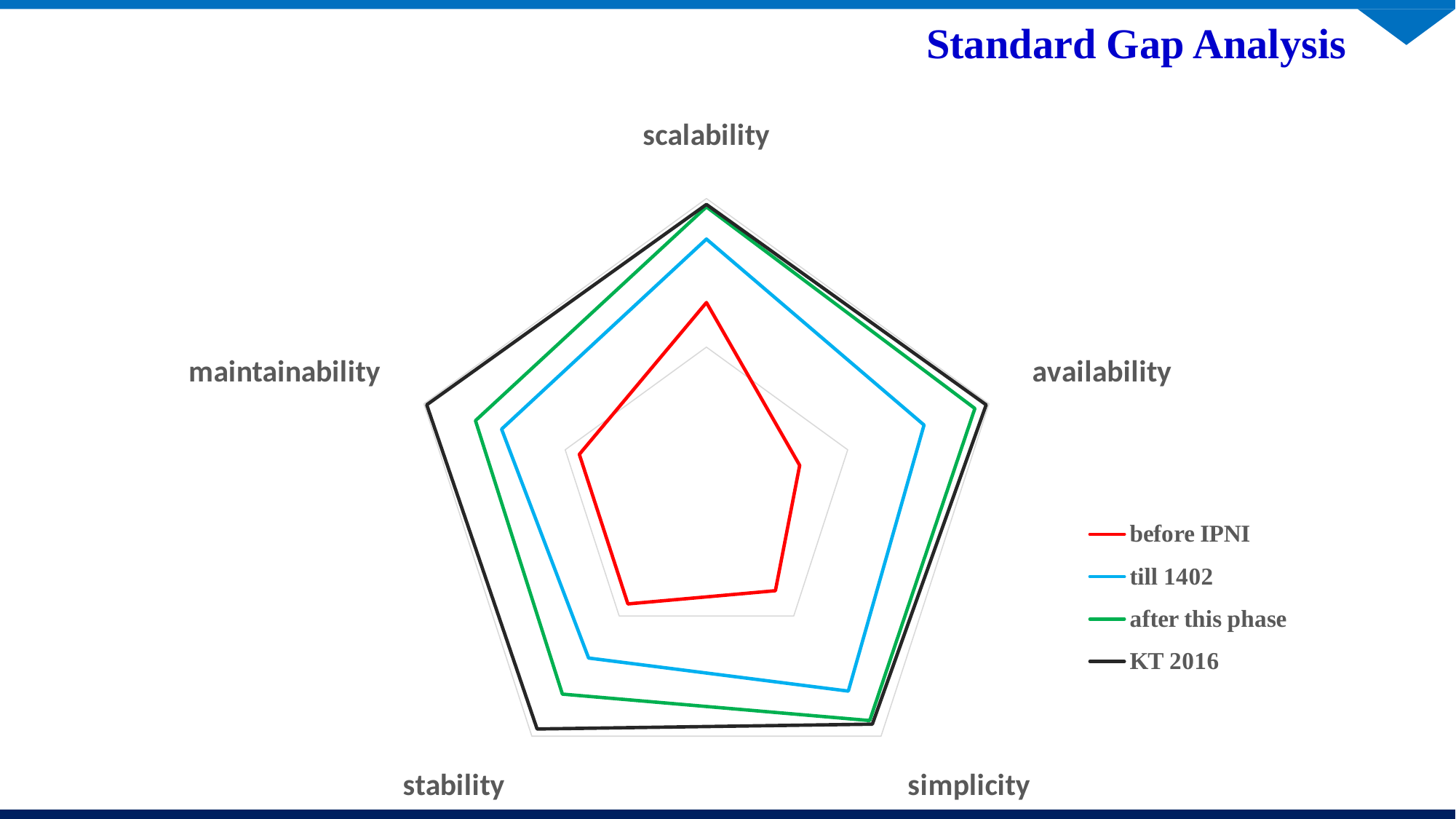
What kind of chart is shown on the slide? Radar chart For the 'before IPNI' series, which category has the highest value? scalability For scalability, which series has a larger value: 'KT 2016' or 'before IPNI'? KT 2016 For maintainability, which series has a larger value: 'KT 2016' or 'after this phase'? KT 2016 How many series does the legend list? 4 Which series has the largest values across all categories? KT 2016 What is the title of the slide containing the chart? Standard Gap Analysis For simplicity, which series has a larger value: 'till 1402' or 'before IPNI'? till 1402 Which colour represents the 'after this phase' series? Green Which series has the smallest values across all categories? before IPNI How many categories (axes) does the radar chart have? 5